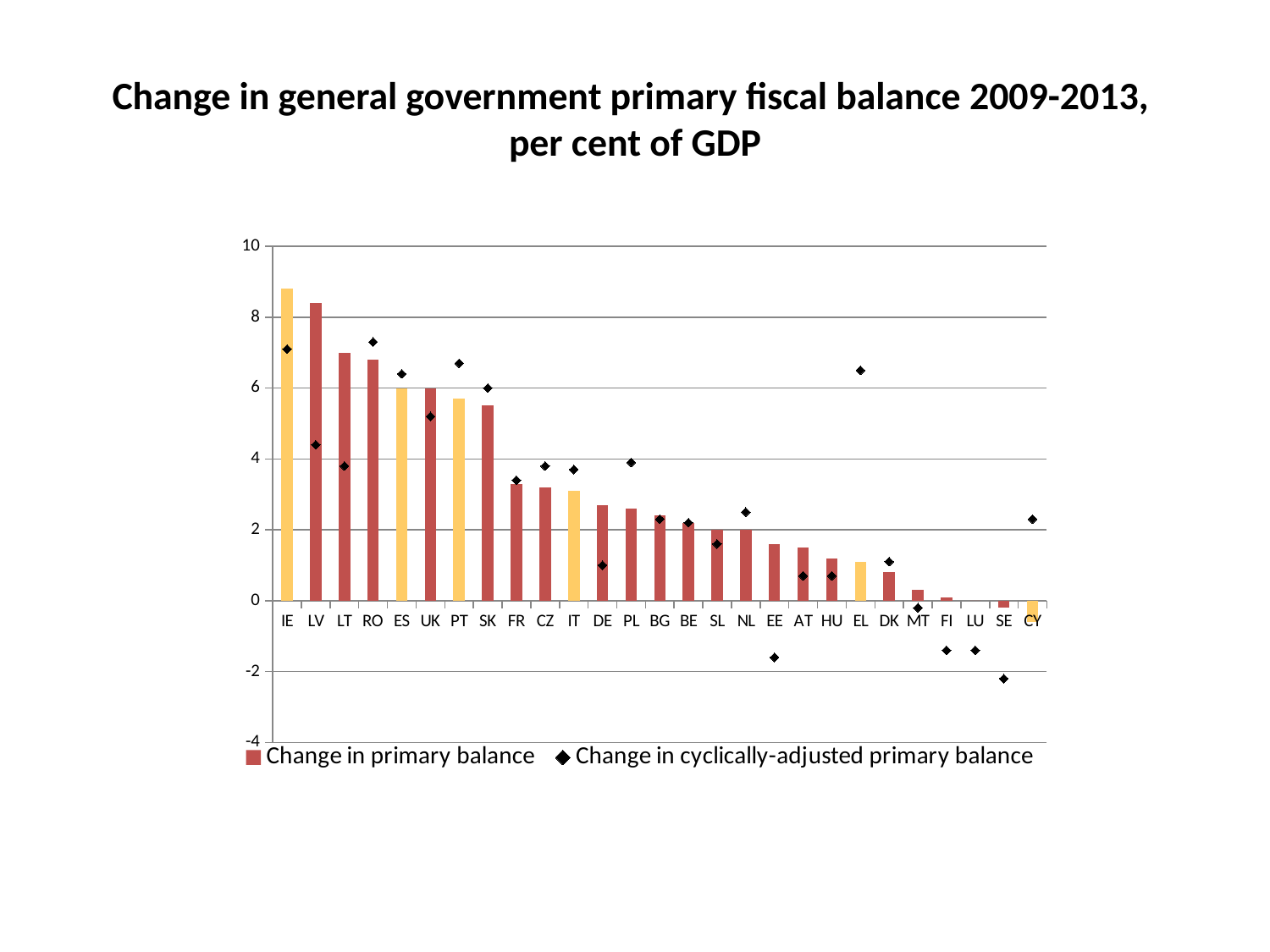
What kind of chart is shown on the slide? bar chart with a line/marker series How many countries are shown on the x axis? 27 Do the change in primary balance bars generally rise or fall from left to right along the x axis? fall Which country has the lowest marker for change in cyclically-adjusted primary balance? SE Is the change in primary balance bar for LV greater or less than 8? greater What is the title of the chart? Change in general government primary fiscal balance 2009-2013, per cent of GDP Which has the larger change in primary balance bar, LV or LT? LV Is the change in cyclically-adjusted primary balance marker for EL greater or less than 6? greater Is the change in primary balance bar for EE greater or less than 2? less How many series does the legend list? 2 Which country has the highest bar for change in primary balance? IE